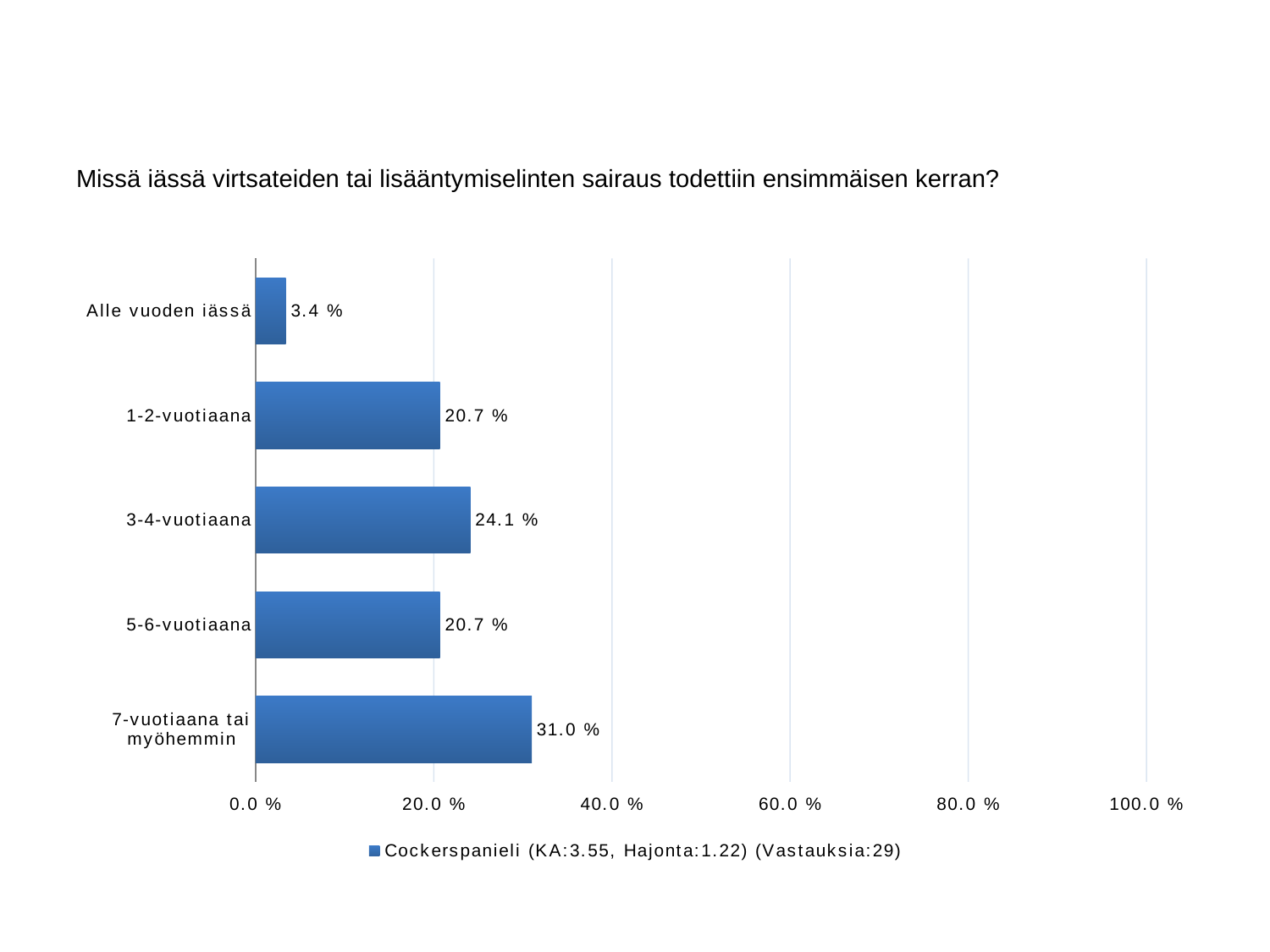
Which category has the highest value? 7-vuotiaana tai myöhemmin How many responses (Vastauksia) does the legend entry report? 29 What kind of chart is shown on the slide? bar chart What is the value for "7-vuotiaana tai myöhemmin"? 31.0 % What is the difference between the values for "7-vuotiaana tai myöhemmin" and "3-4-vuotiaana"? 6.9 % How many series does the legend list? 1 What is the value for "3-4-vuotiaana"? 24.1 % Is the value for "7-vuotiaana tai myöhemmin" greater or less than 40.0 %? less How many categories are shown in the chart? 5 Which is larger, the value for "3-4-vuotiaana" or the value for "1-2-vuotiaana"? 3-4-vuotiaana What is the value for "Alle vuoden iässä"? 3.4 % Which category has the lowest value? Alle vuoden iässä